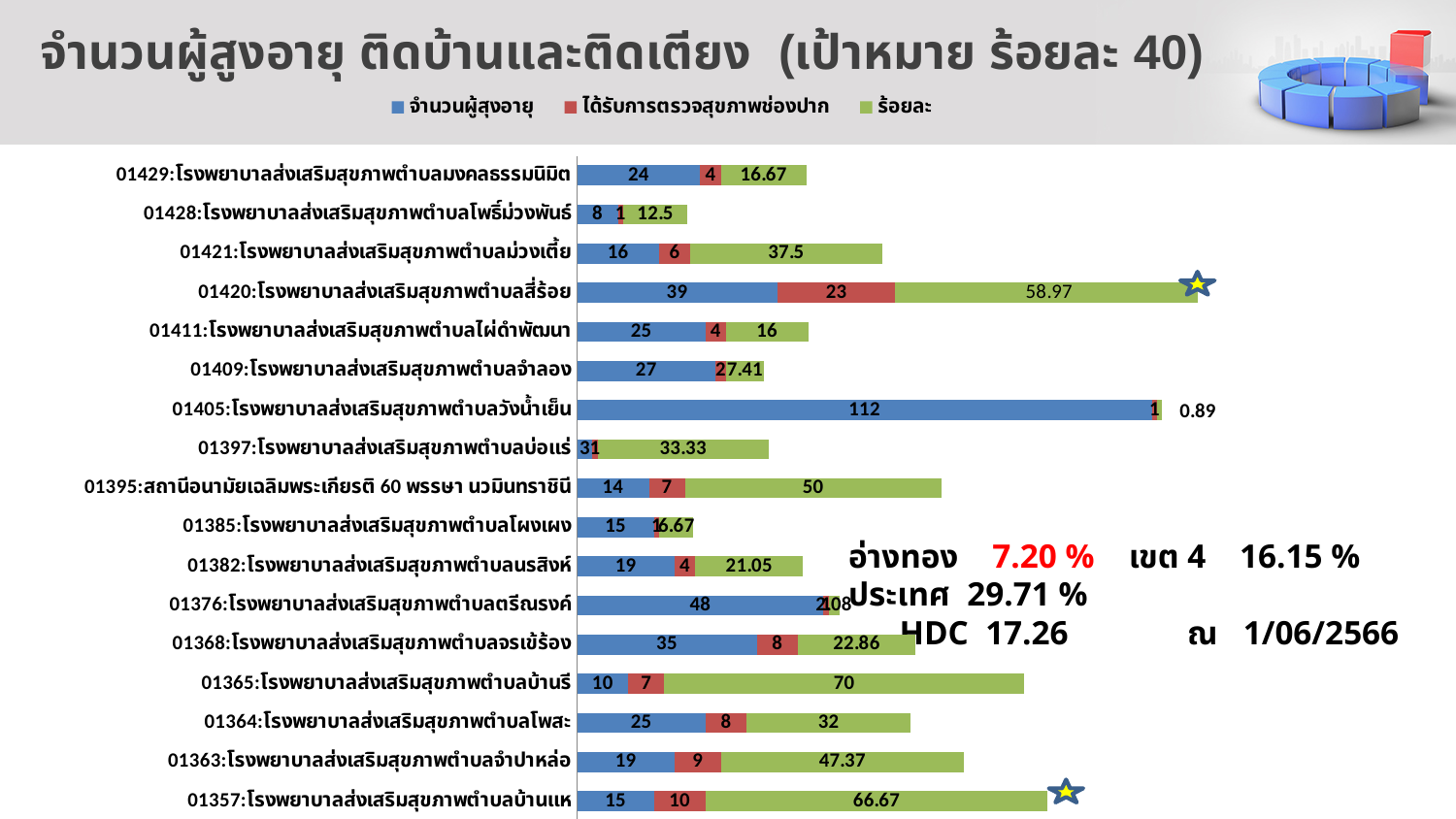
How many series does the legend list? 3 What is the จำนวนผู้สูงอายุ value for 01405:โรงพยาบาลส่งเสริมสุขภาพตำบลวังน้ำเย็น? 112 Which category has the highest ร้อยละ value? 01365:โรงพยาบาลส่งเสริมสุขภาพตำบลบ้านรี Which category has the lowest ร้อยละ value? 01405:โรงพยาบาลส่งเสริมสุขภาพตำบลวังน้ำเย็น Which category has the highest ได้รับการตรวจสุขภาพช่องปาก value? 01420:โรงพยาบาลส่งเสริมสุขภาพตำบลสี่ร้อย What is the ร้อยละ value for 01420:โรงพยาบาลส่งเสริมสุขภาพตำบลสี่ร้อย? 58.97 Which has the larger ร้อยละ value: 01364:โรงพยาบาลส่งเสริมสุขภาพตำบลโพสะ or 01363:โรงพยาบาลส่งเสริมสุขภาพตำบลจำปาหล่อ? 01363:โรงพยาบาลส่งเสริมสุขภาพตำบลจำปาหล่อ What kind of chart is shown on the slide? bar chart How many categories (health facilities) are plotted on the chart? 17 What is the target percentage stated in the chart title? ร้อยละ 40 What is the difference between จำนวนผู้สูงอายุ and ได้รับการตรวจสุขภาพช่องปาก for 01420:โรงพยาบาลส่งเสริมสุขภาพตำบลสี่ร้อย? 16 What is the ได้รับการตรวจสุขภาพช่องปาก value for 01357:โรงพยาบาลส่งเสริมสุขภาพตำบลบ้านแห? 10